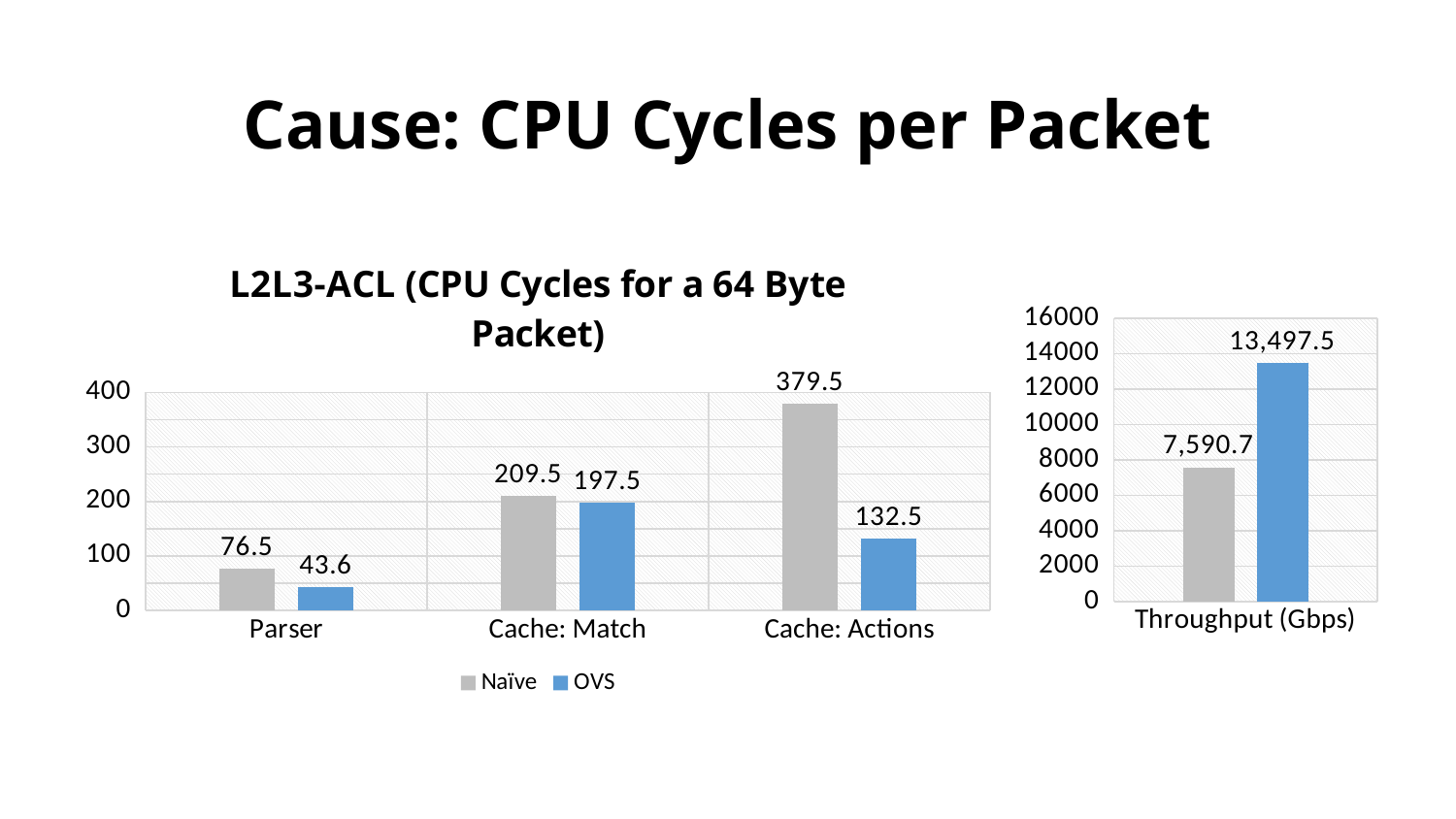
In the L2L3-ACL chart, which category has the lowest OVS value? Parser In the L2L3-ACL chart, which is larger for Cache: Match, the Naïve value or the OVS value? Naïve How many categories are shown on the x axis of the L2L3-ACL chart? 3 In the L2L3-ACL chart, what is the difference between the Naïve and OVS values for Parser? 32.9 In the chart on the right of the slide, what is the difference between the blue bar and the gray bar for Throughput (Gbps)? 5,906.8 In the L2L3-ACL chart, which category has the highest Naïve value? Cache: Actions In the chart on the right of the slide, what is the value of the blue bar for Throughput (Gbps)? 13,497.5 How many series does the legend of the L2L3-ACL chart list? 2 In the L2L3-ACL chart, what is the Naïve value for Cache: Actions? 379.5 In the L2L3-ACL chart, what is the OVS value for Parser? 43.6 In the L2L3-ACL chart, what is the OVS value for Cache: Match? 197.5 In the L2L3-ACL chart, what is the difference between the Naïve and OVS values for Cache: Actions? 247